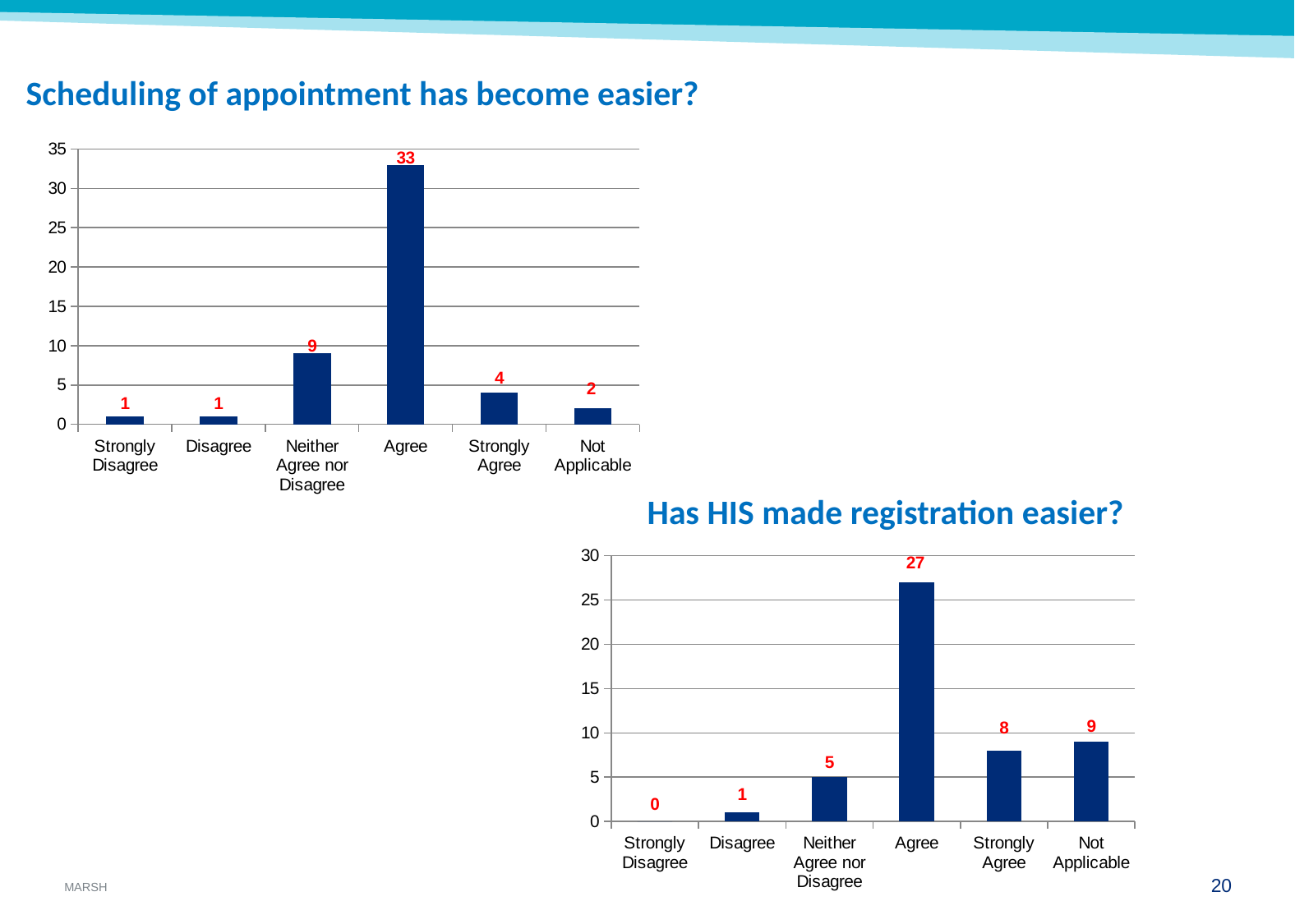
In the 'Scheduling of appointment has become easier?' chart, how many categories are shown on the x axis? 6 In the 'Scheduling of appointment has become easier?' chart, what is the difference between the values for Agree and Strongly Agree? 29 In the 'Has HIS made registration easier?' chart, what is the value for Agree? 27 In the 'Has HIS made registration easier?' chart, what is the difference between the values for Agree and Neither Agree nor Disagree? 22 In the 'Scheduling of appointment has become easier?' chart, which category has the highest value? Agree What kind of chart is the 'Has HIS made registration easier?' chart? Bar chart In the 'Has HIS made registration easier?' chart, which is larger, the value for Strongly Agree or the value for Not Applicable? Not Applicable In the 'Has HIS made registration easier?' chart, what is the value for Not Applicable? 9 In the 'Scheduling of appointment has become easier?' chart, what colour are the bars? Dark blue In the 'Scheduling of appointment has become easier?' chart, what is the value for Neither Agree nor Disagree? 9 In the 'Scheduling of appointment has become easier?' chart, what is the value for Agree? 33 In the 'Has HIS made registration easier?' chart, which category has the lowest value? Strongly Disagree